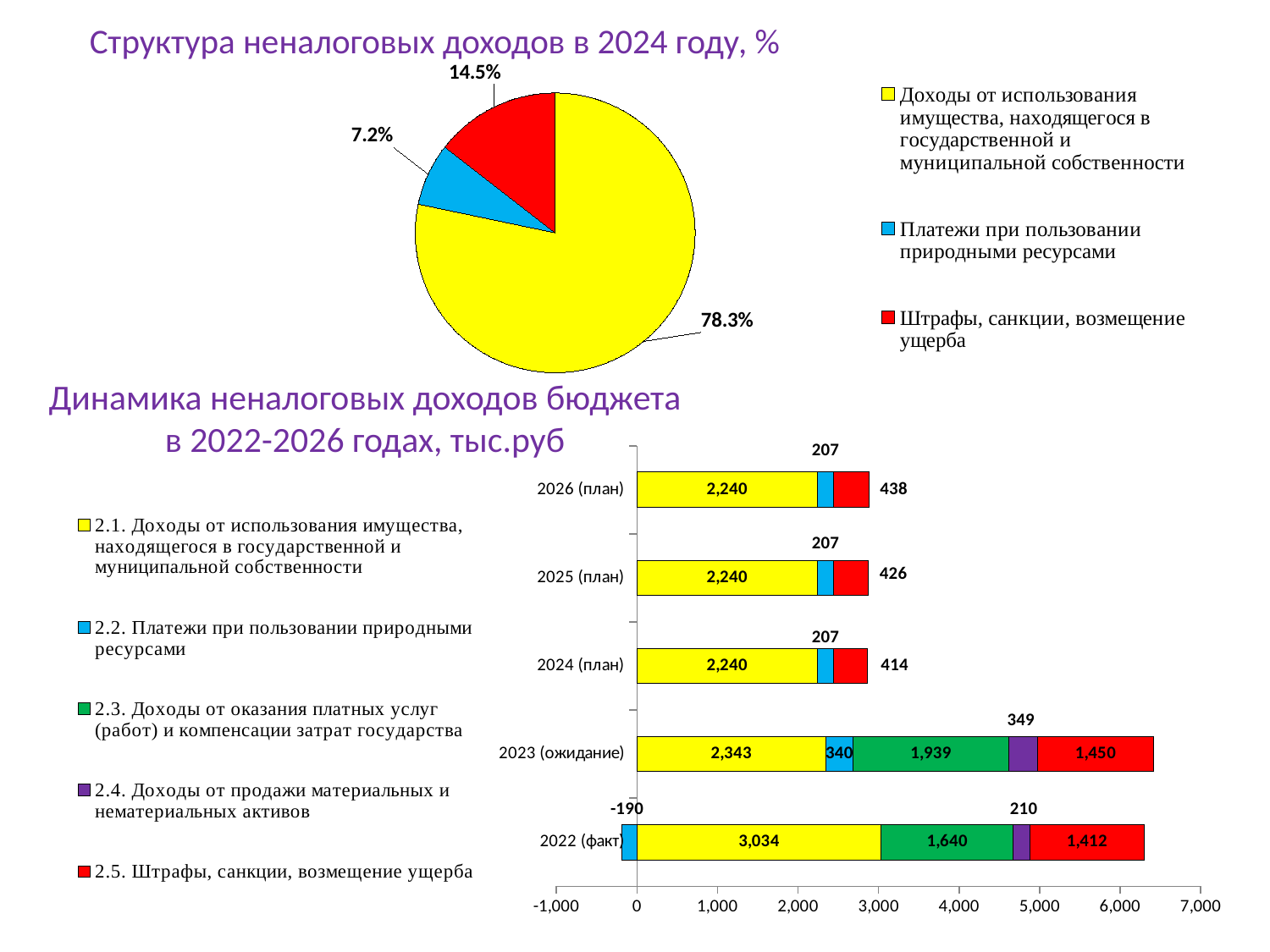
In the chart "Динамика неналоговых доходов бюджета в 2022-2026 годах, тыс.руб", what is the value of "2.5. Штрафы, санкции, возмещение ущерба" for 2026 (план)? 438 In the pie chart "Структура неналоговых доходов в 2024 году, %", which category has the smallest slice? Платежи при пользовании природными ресурсами What kind of chart is the chart titled "Структура неналоговых доходов в 2024 году, %"? pie chart In the chart "Динамика неналоговых доходов бюджета в 2022-2026 годах, тыс.руб", what is the value of "2.2. Платежи при пользовании природными ресурсами" for 2022 (факт)? -190 In the pie chart "Структура неналоговых доходов в 2024 году, %", what share is shown for "Штрафы, санкции, возмещение ущерба"? 14.5% How many entries does the legend of the pie chart "Структура неналоговых доходов в 2024 году, %" list? 3 In the chart "Динамика неналоговых доходов бюджета в 2022-2026 годах, тыс.руб", what is the total of the stacked bar for 2024 (план)? 2,861 What kind of chart is the chart titled "Динамика неналоговых доходов бюджета в 2022-2026 годах, тыс.руб"? bar chart In the pie chart "Структура неналоговых доходов в 2024 году, %", which category has the largest slice? Доходы от использования имущества, находящегося в государственной и муниципальной собственности How many series does the legend of the chart "Динамика неналоговых доходов бюджета в 2022-2026 годах, тыс.руб" list? 5 How many categories (years) are shown in the chart "Динамика неналоговых доходов бюджета в 2022-2026 годах, тыс.руб"? 5 In the chart "Динамика неналоговых доходов бюджета в 2022-2026 годах, тыс.руб", what is the difference between the "2.1. Доходы от использования имущества" values for 2022 (факт) and 2023 (ожидание)? 691